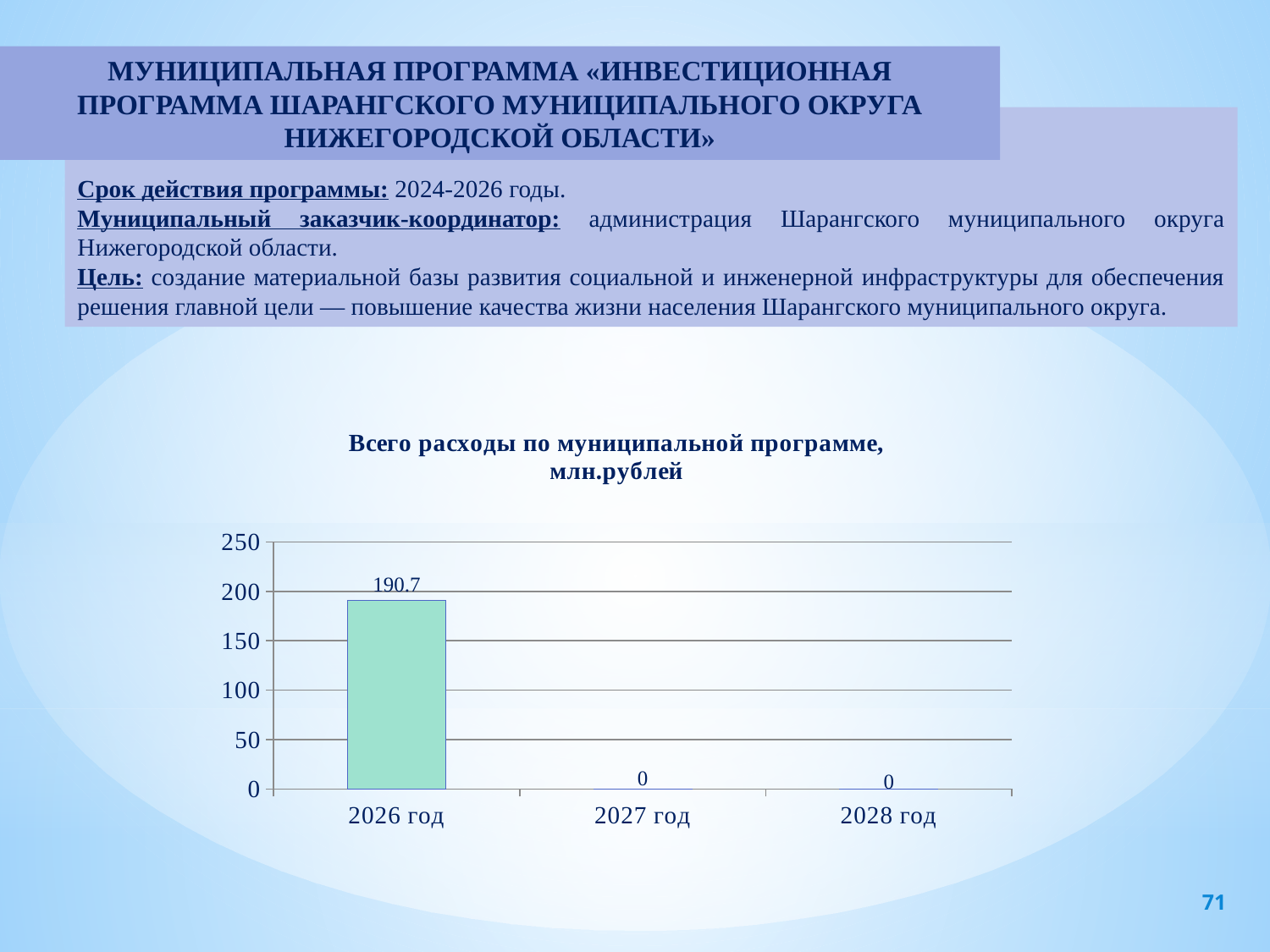
How many categories are shown on the x axis? 3 Which year has the highest value? 2026 год Which is larger, the value for 2026 год or the value for 2028 год? 2026 год What is the value for 2027 год? 0 What kind of chart is shown on the slide? bar chart What is the value for 2026 год? 190.7 Is the value for 2026 год greater or less than 200? less What is the difference between the values for 2026 год and 2027 год? 190.7 What is the value for 2028 год? 0 Do the values rise or fall from 2026 год to 2028 год? fall What is the title of the chart? Всего расходы по муниципальной программе, млн.рублей Is the value for 2026 год greater or less than 150? greater